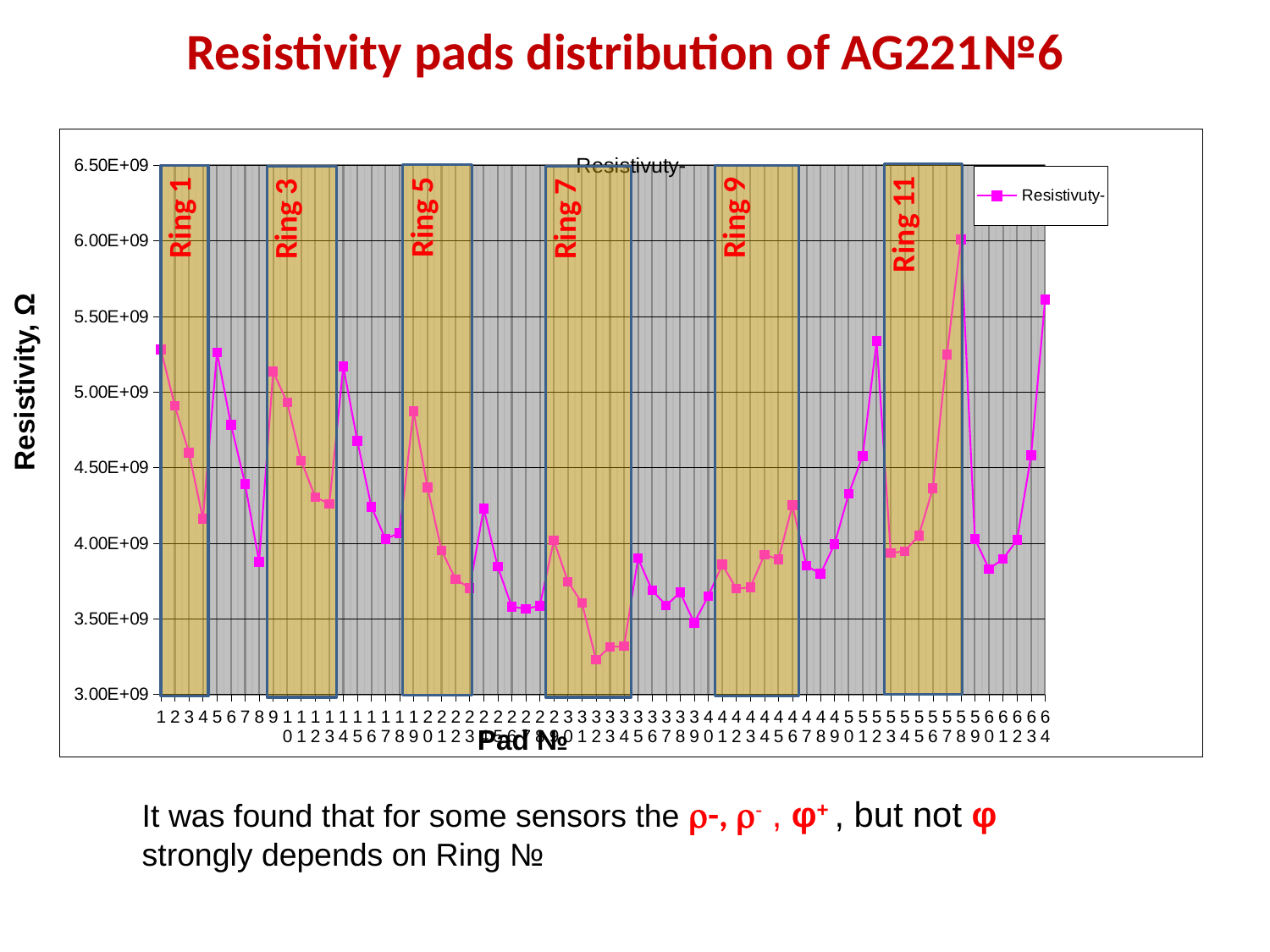
How many series does the chart legend list? 1 Which pad number has the lowest resistivity value on the chart? 32 What is the title of the y axis of the chart? Resistivity, Ω What kind of chart is shown on the slide? line chart How many pads (x-axis categories) are plotted on the chart? 64 Is the resistivity value for pad 31 greater or less than 3.50E+09? greater Which has the larger resistivity value, pad 1 or pad 31? pad 1 Do the resistivity values rise or fall from pad 1 to pad 4 (Ring 1)? fall Is the resistivity value for pad 1 greater or less than 5.00E+09? greater Is the resistivity value for pad 8 greater or less than 4.00E+09? less What is the title of the x axis of the chart? Pad № Which pad number has the highest resistivity value on the chart? 58